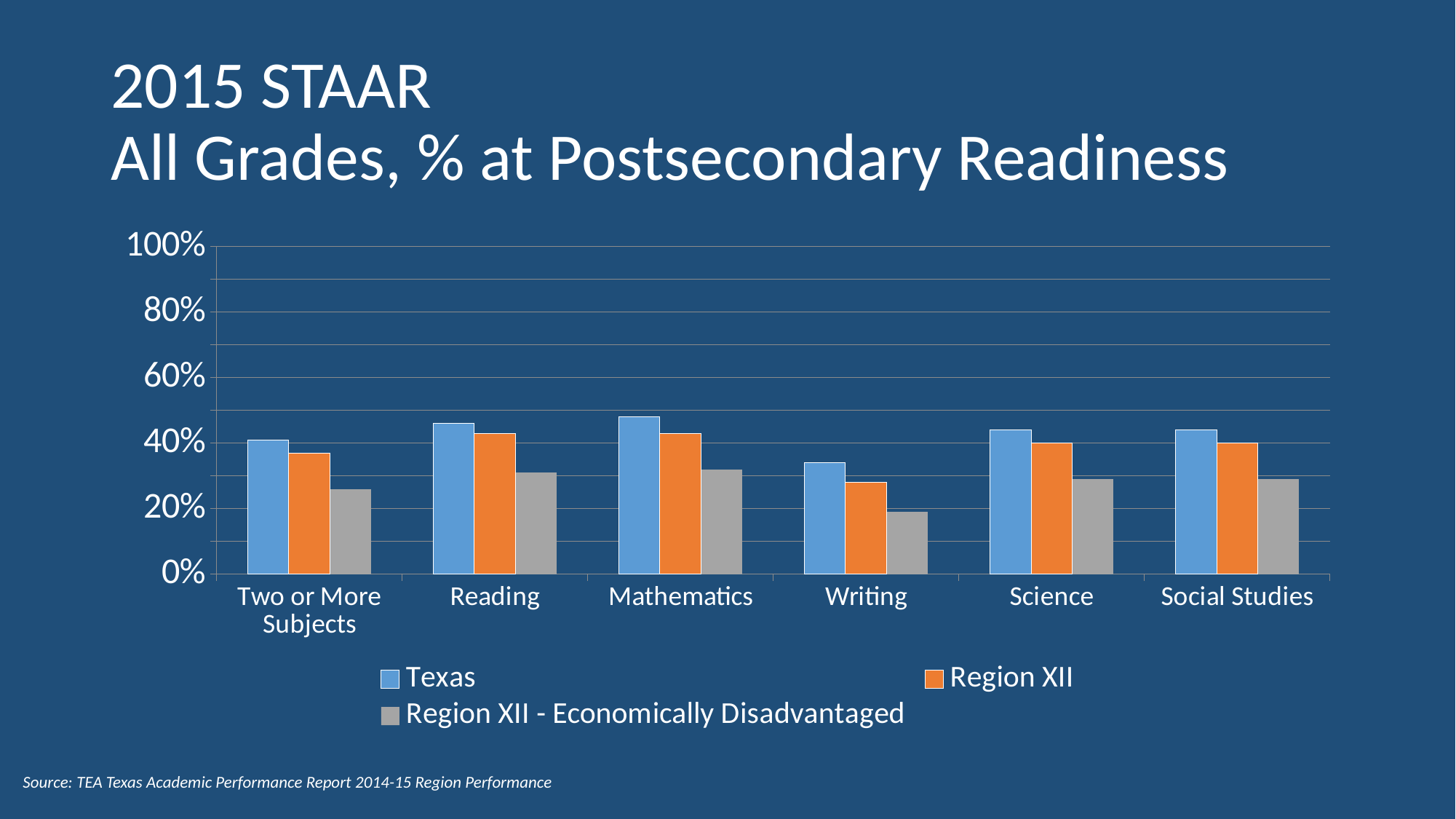
Which series is shown in orange in the legend? Region XII Is the Region XII - Economically Disadvantaged value for Mathematics greater or less than 40%? less For Writing, which is larger: the Texas value or the Region XII value? Texas Which subject has the lowest value for the Texas series? Writing Which subject has the lowest value for the Region XII - Economically Disadvantaged series? Writing How many series does the legend list? 3 Is the Texas value for Mathematics greater or less than 40%? greater Is the Texas value for Writing greater or less than 40%? less What kind of chart is shown on the slide? bar chart For Reading, which is larger: the Region XII value or the Region XII - Economically Disadvantaged value? Region XII How many subject categories are shown on the x axis? 6